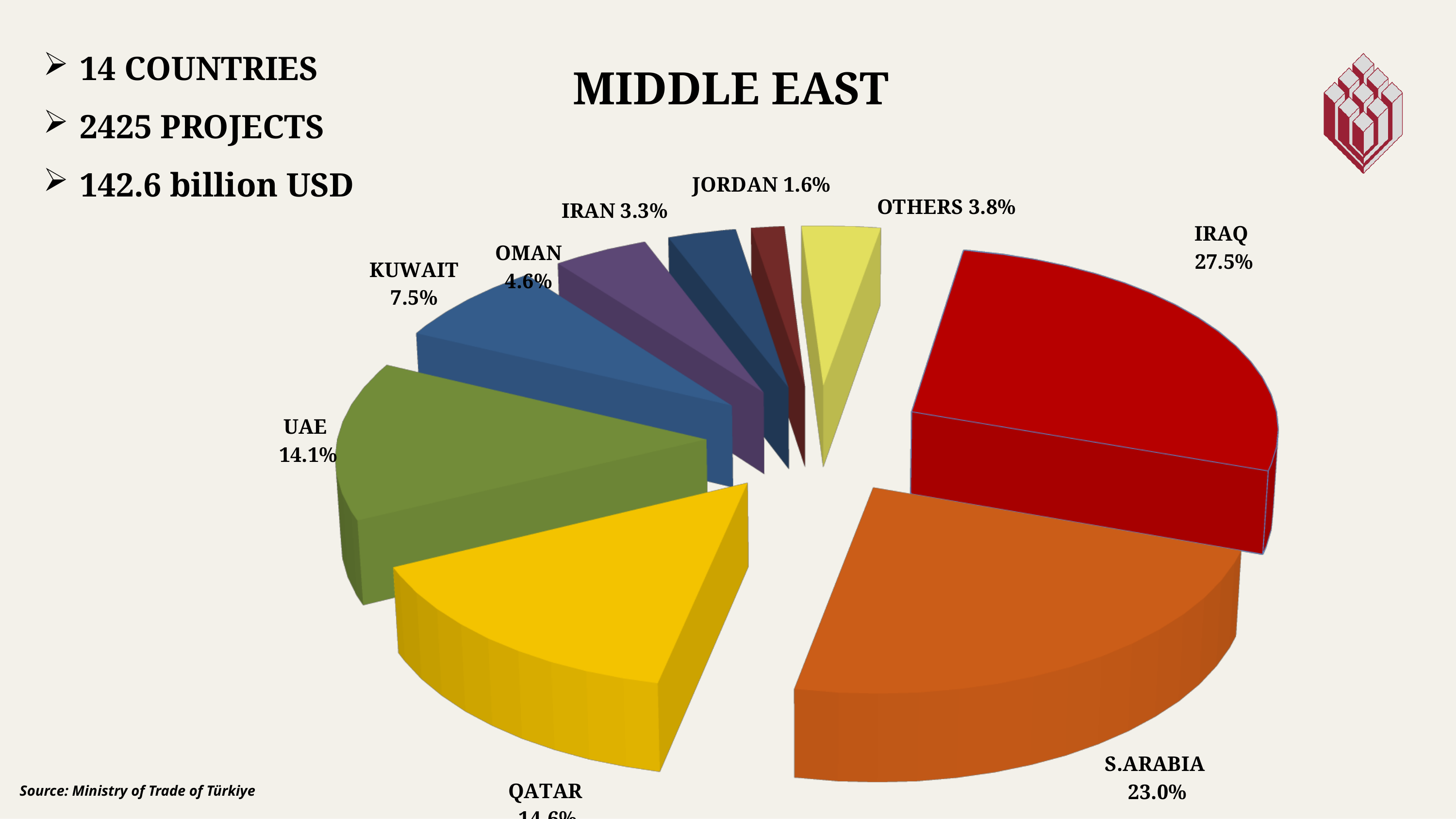
What share of the pie does IRAQ have? 27.5% What kind of chart is shown on the slide? Pie chart What share of the pie does OMAN have? 4.6% What share of the pie does S.ARABIA have? 23.0% What share of the pie does KUWAIT have? 7.5% What share of the pie does UAE have? 14.1% What is the title of the chart? MIDDLE EAST Which slice of the pie is the smallest? JORDAN What share of the pie does JORDAN have? 1.6% What is the difference in percentage points between IRAQ and S.ARABIA? 4.5 Which has a larger share, KUWAIT or OMAN? KUWAIT Which slice of the pie is the largest? IRAQ